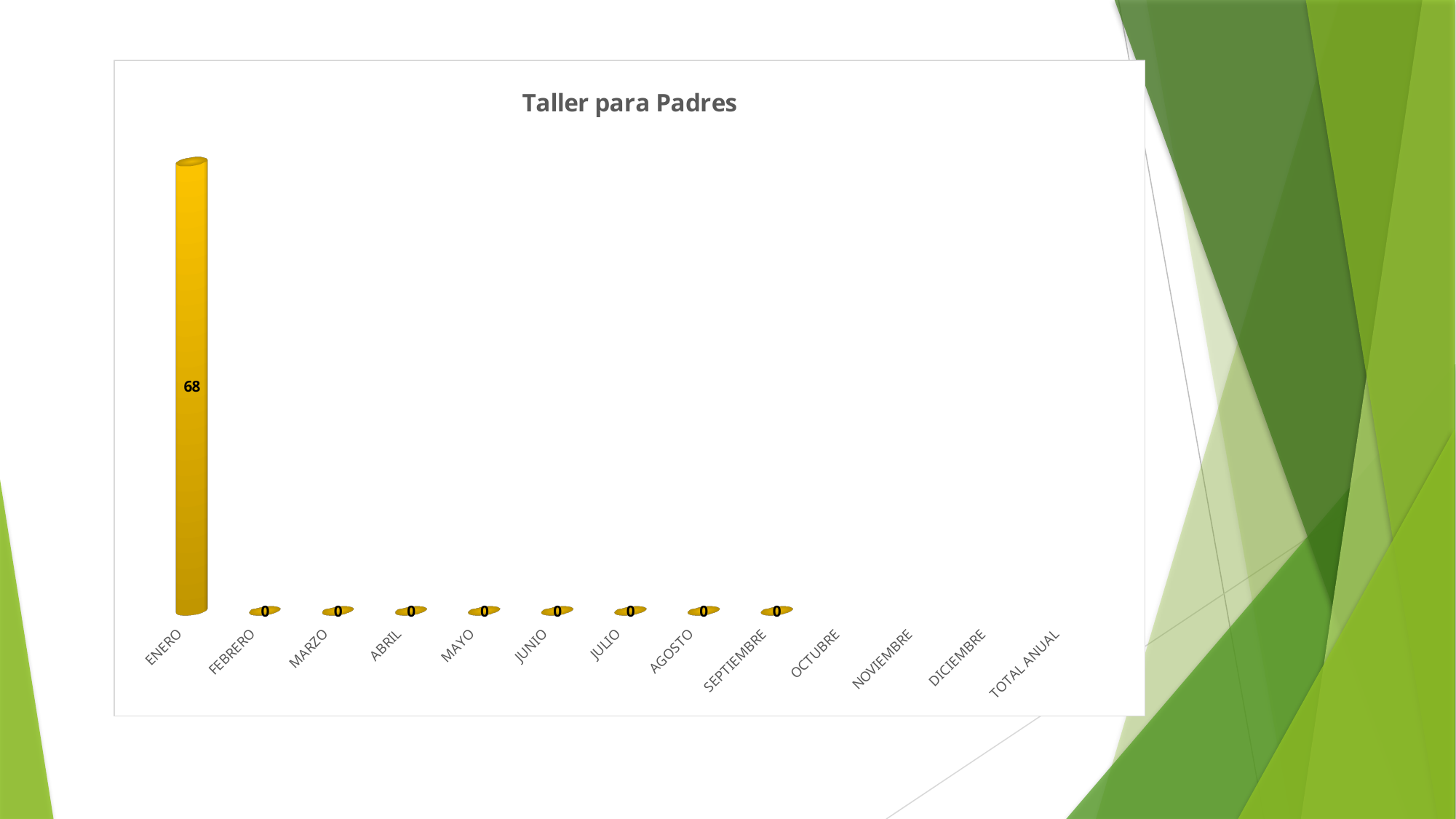
What is the value for MARZO? 0 What kind of chart is shown on the slide? Bar chart What is the value for AGOSTO? 0 Which is larger, the value for ENERO or the value for JULIO? ENERO What colour are the bars in the chart? Yellow What is the value for SEPTIEMBRE? 0 Which category has the highest value? ENERO What is the value for ENERO in the Taller para Padres chart? 68 What is the title of the chart? Taller para Padres How many category labels are shown on the x axis? 13 How many categories have a data label of 0? 8 What is the difference between the values for ENERO and FEBRERO? 68